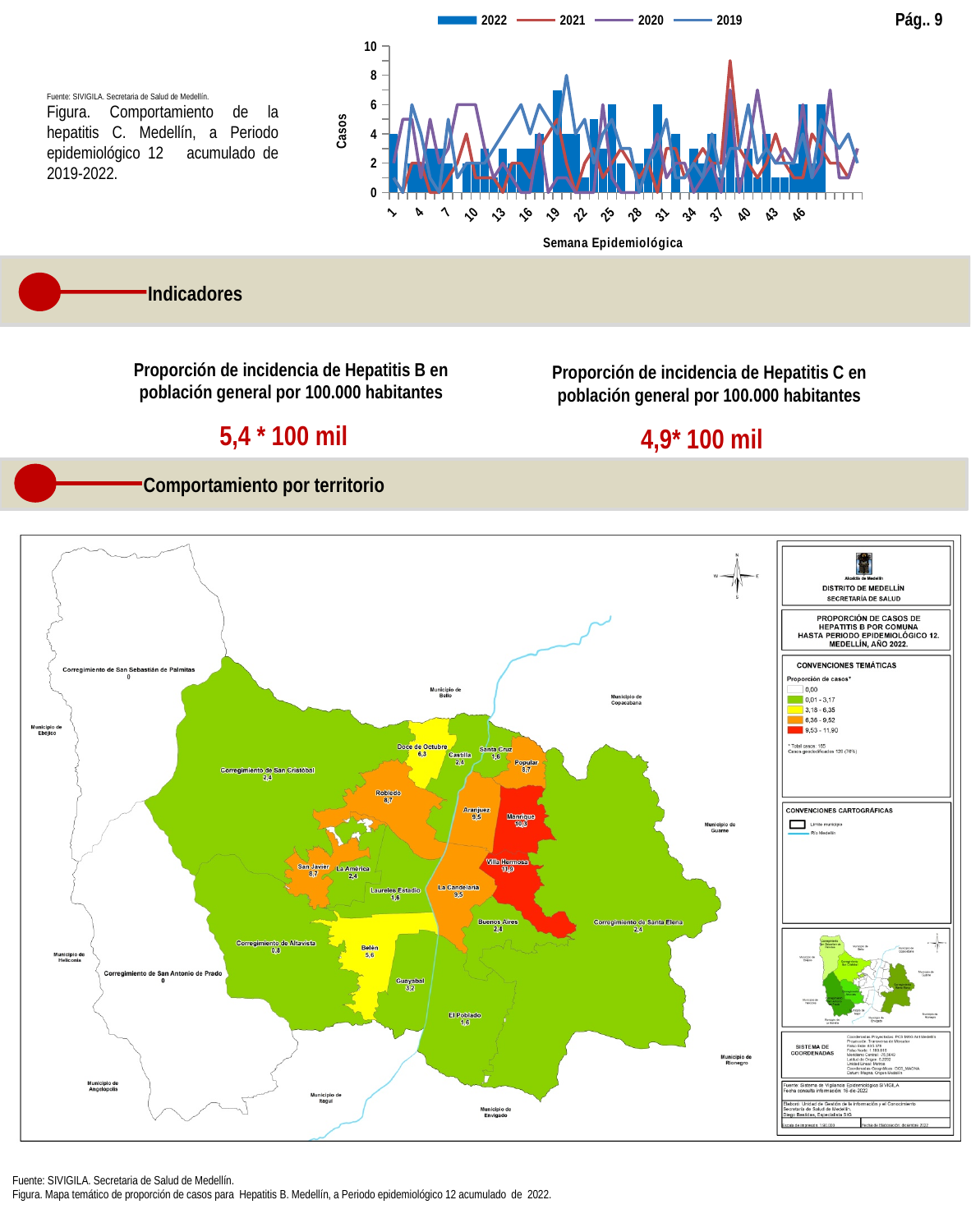
On the hepatitis B map, what is the proportion of cases printed for Belén? 5,6 On the hepatitis B map, what is the proportion of cases printed for Robledo? 8,7 In the hepatitis C chart, is the peak value of the 2021 line (around week 38) greater or less than 8? greater What is the highest value shown on the vertical axis of the hepatitis C chart? 10 On the hepatitis B map, which comuna has the highest printed proportion of cases? Villa Hermosa In the hepatitis C chart, is the 2022 bar at week 1 greater or less than 6? less On the hepatitis B map, which has the larger printed proportion, Aranjuez or Popular? Aranjuez How many series does the legend of the hepatitis C chart list? 4 What is the title of the vertical axis of the hepatitis C chart? Casos What kind of chart is the hepatitis C chart at the top of the slide? A combination bar and line chart In the hepatitis C chart, which year is plotted as bars rather than a line? 2022